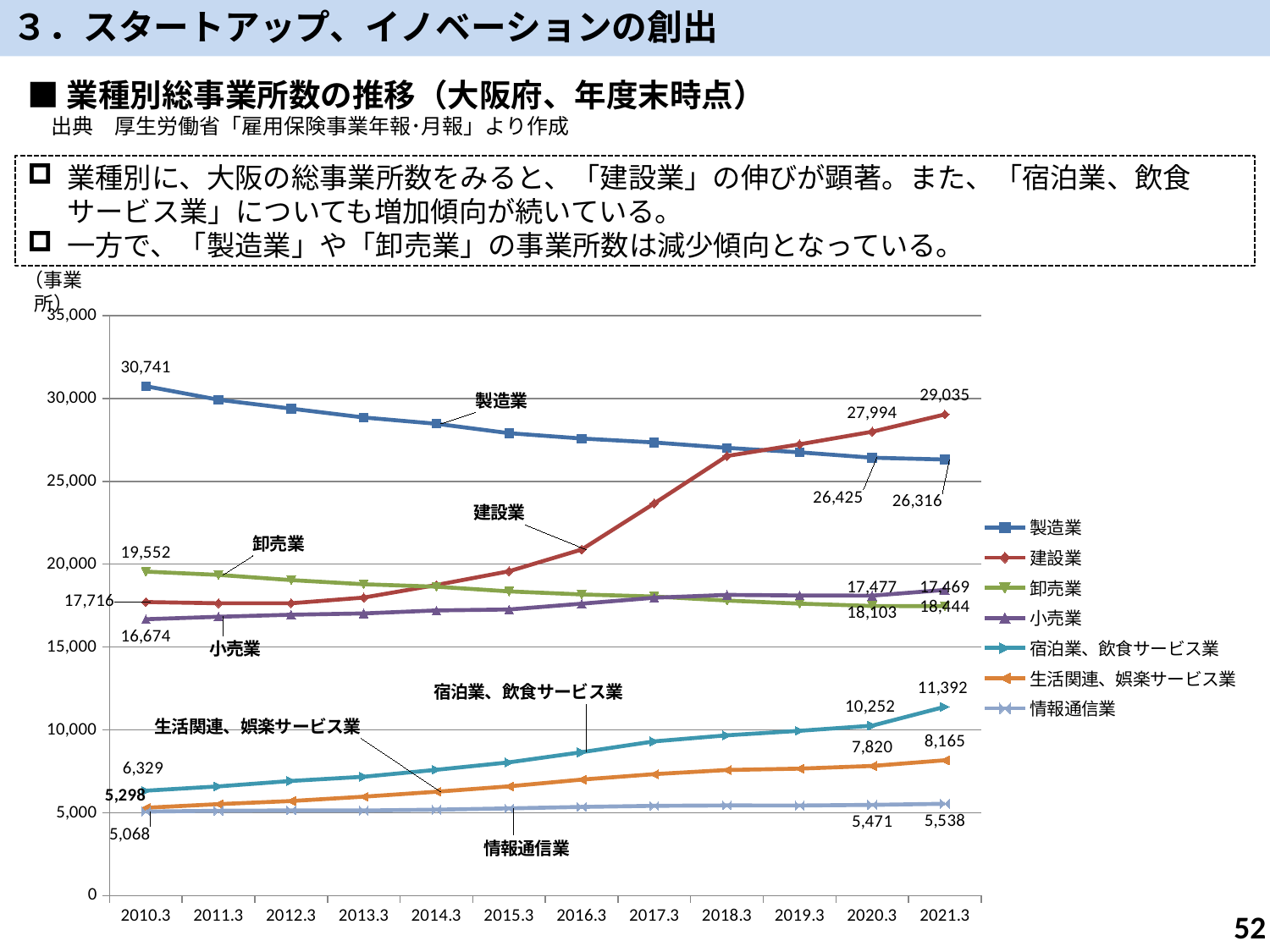
What kind of chart is shown on the slide? line chart How many series does the legend list? 7 Which series has the highest value at 2021.3? 建設業 What is the value for 宿泊業、飲食サービス業 at 2021.3? 11,392 By how much did the value for 建設業 increase from 2020.3 to 2021.3? 1,041 How many time points are shown on the x axis? 12 By how much did the value for 製造業 fall from 2010.3 to 2021.3? 4,425 Which series has the lowest value at 2010.3? 情報通信業 What is the value for 建設業 at 2021.3? 29,035 What is the value for 情報通信業 at 2020.3? 5,471 Does the value for 製造業 rise or fall from 2010.3 to 2021.3? fall What is the value for 製造業 at 2010.3? 30,741